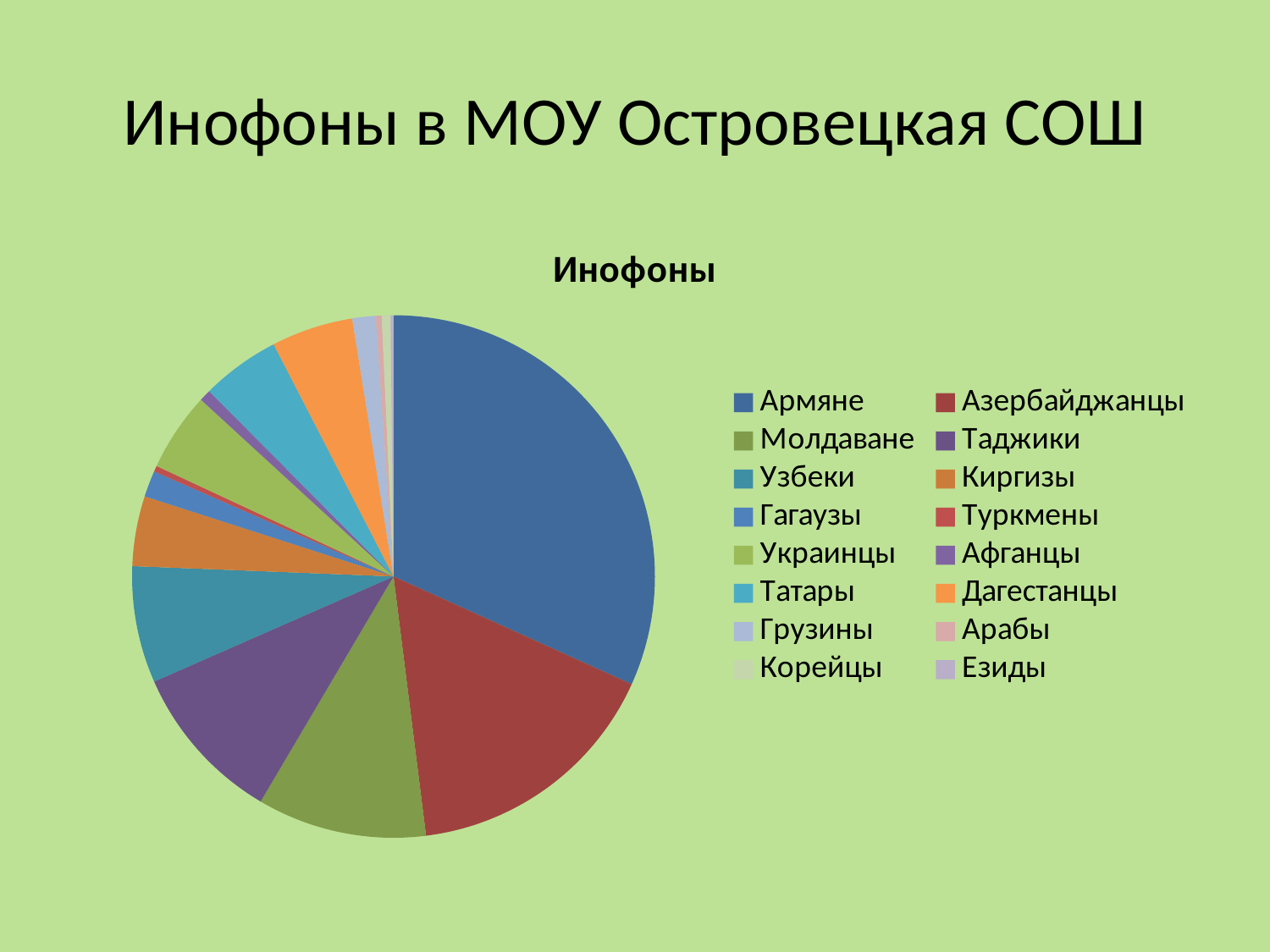
How many categories does the legend of the pie chart list? 16 Which slice is larger, Украинцы or Гагаузы? Украинцы What kind of chart is shown on the slide? pie chart What colour is the slice for Армяне in the pie chart? blue Which slice is larger, Таджики or Узбеки? Таджики Which category has the largest slice of the pie chart? Армяне Which slice is larger, Армяне or Азербайджанцы? Армяне What is the title of the pie chart? Инофоны